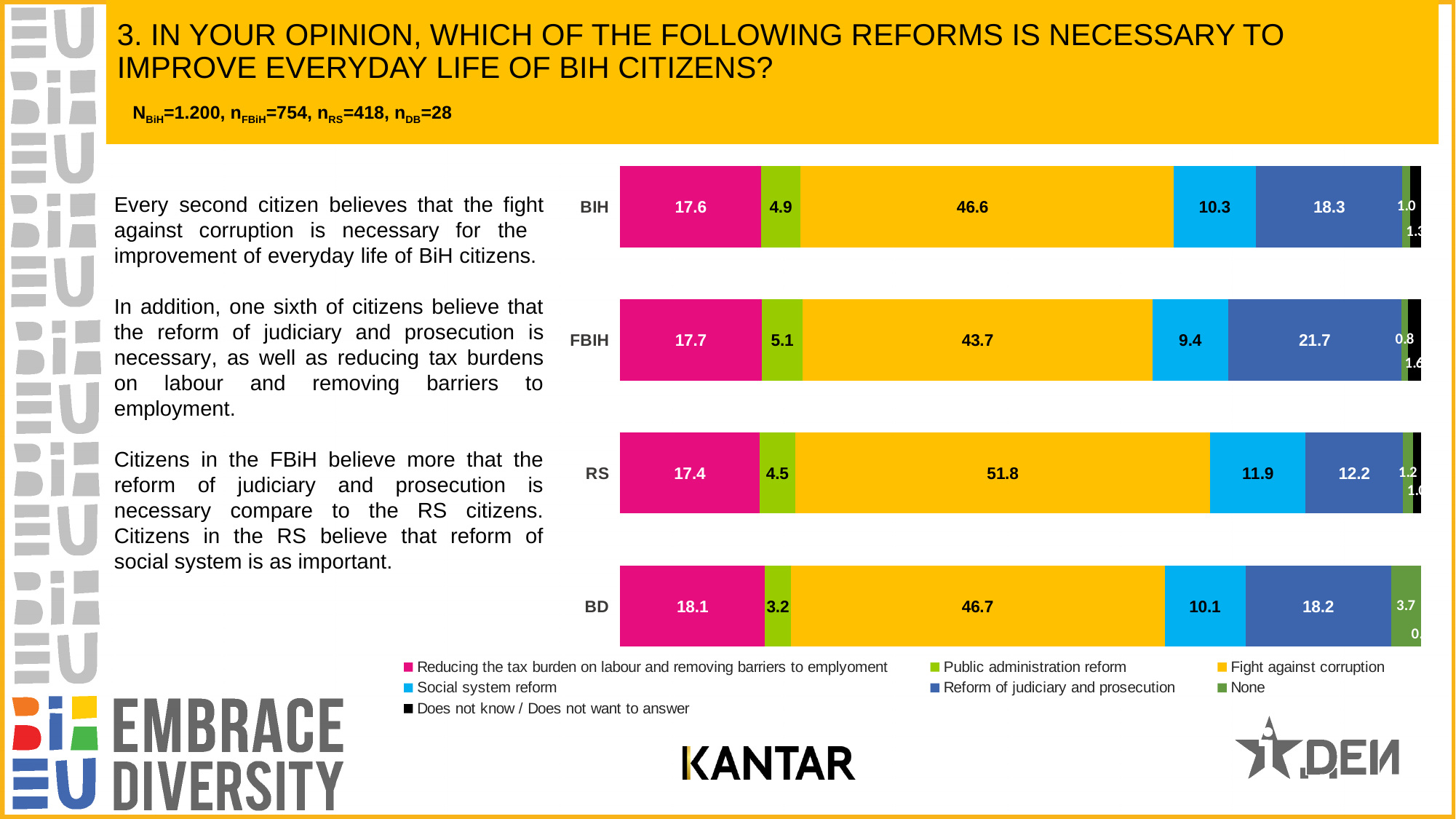
How many series does the legend list? 7 Which region has the lowest value for Reform of judiciary and prosecution? RS Which region has the highest value for Fight against corruption? RS What is the difference between the Reform of judiciary and prosecution values for FBIH and RS? 9.5 What is the value for Social system reform in the BD bar? 10.1 How many categories (regions) are plotted on the chart? 4 What kind of chart is shown on the slide? Stacked bar chart What is the value for Fight against corruption in the RS bar? 51.8 What is the value for Public administration reform in the BIH bar? 4.9 Which is larger: the Social system reform value for RS or for FBIH? RS What is the value for Reform of judiciary and prosecution in the FBIH bar? 21.7 Which colour represents Fight against corruption in the chart? Yellow